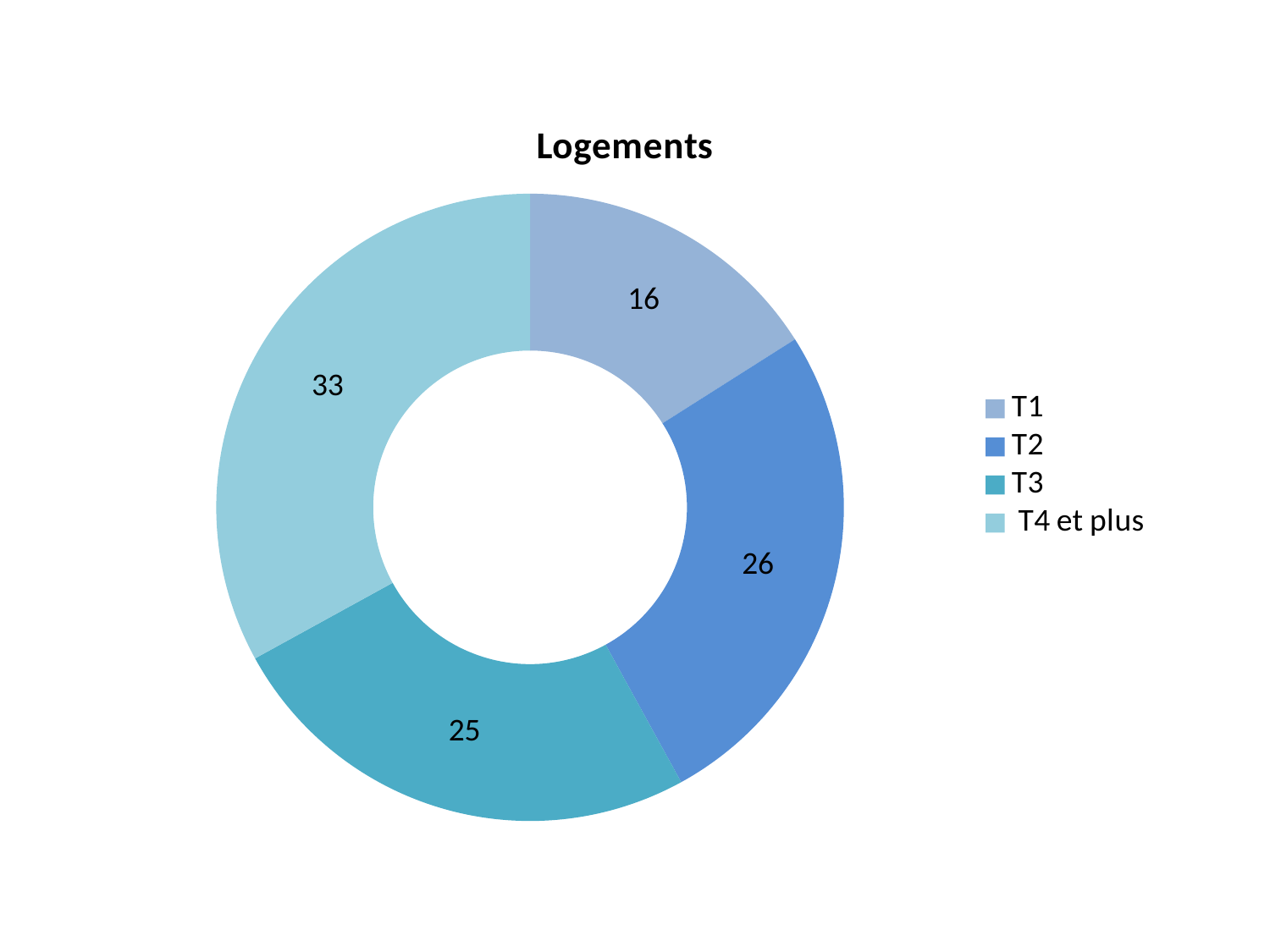
Which is larger, the value for T2 or the value for T1? T2 What is the value for T4 et plus in the Logements chart? 33 How many categories are shown in the Logements chart? 4 What is the value for T1 in the Logements chart? 16 What share of the total does the T4 et plus slice represent? 33% What is the difference between the values for T4 et plus and T1? 17 What kind of chart is shown on the slide? Doughnut chart Which category has the smallest slice in the Logements chart? T1 What is the value for T3 in the Logements chart? 25 What is the title of the chart? Logements What is the difference between the values for T2 and T1? 10 Which category has the largest slice in the Logements chart? T4 et plus